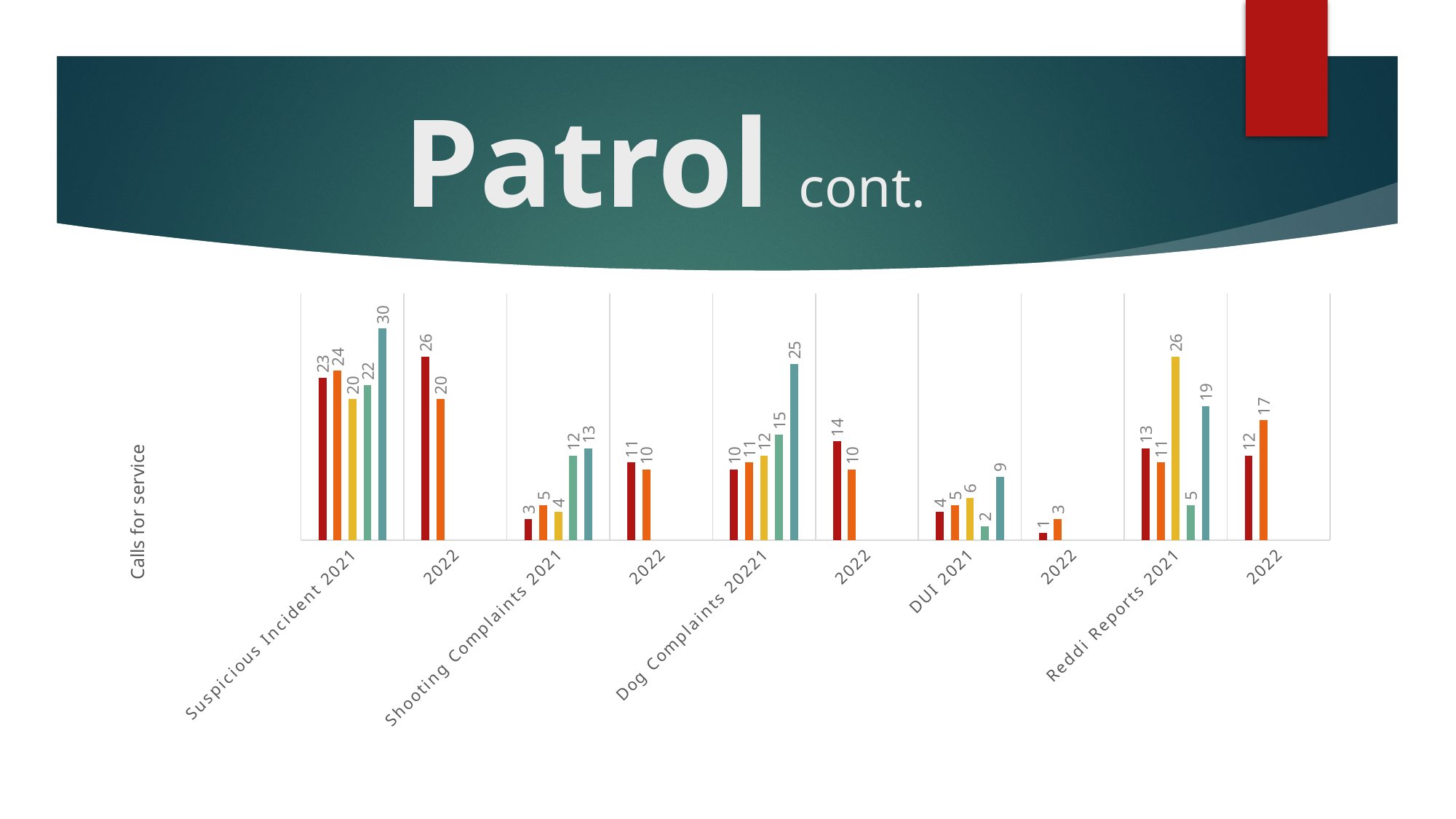
Which bar is the lowest in the DUI 2022 group? the dark red bar (1) What is the value of the dark red bar for the 2022 group following Suspicious Incident 2021? 26 What is the difference between the teal bar (25) and the dark red bar (10) in the Dog Complaints 20221 group? 15 What is the value of the green bar in the DUI 2021 group? 2 What is the value of the teal bar in the Dog Complaints 20221 group? 25 What is the value of the tallest bar in the Suspicious Incident 2021 group? 30 What kind of chart is shown on the slide? bar chart How many categories are shown along the x axis of the chart? 10 What is the value of the yellow bar in the Reddi Reports 2021 group? 26 What is the difference between the orange bar (17) and the dark red bar (12) in the Reddi Reports 2022 group? 5 Which is larger in the Reddi Reports 2021 group: the yellow bar or the teal bar? the yellow bar What is the label on the vertical axis of the chart? Calls for service